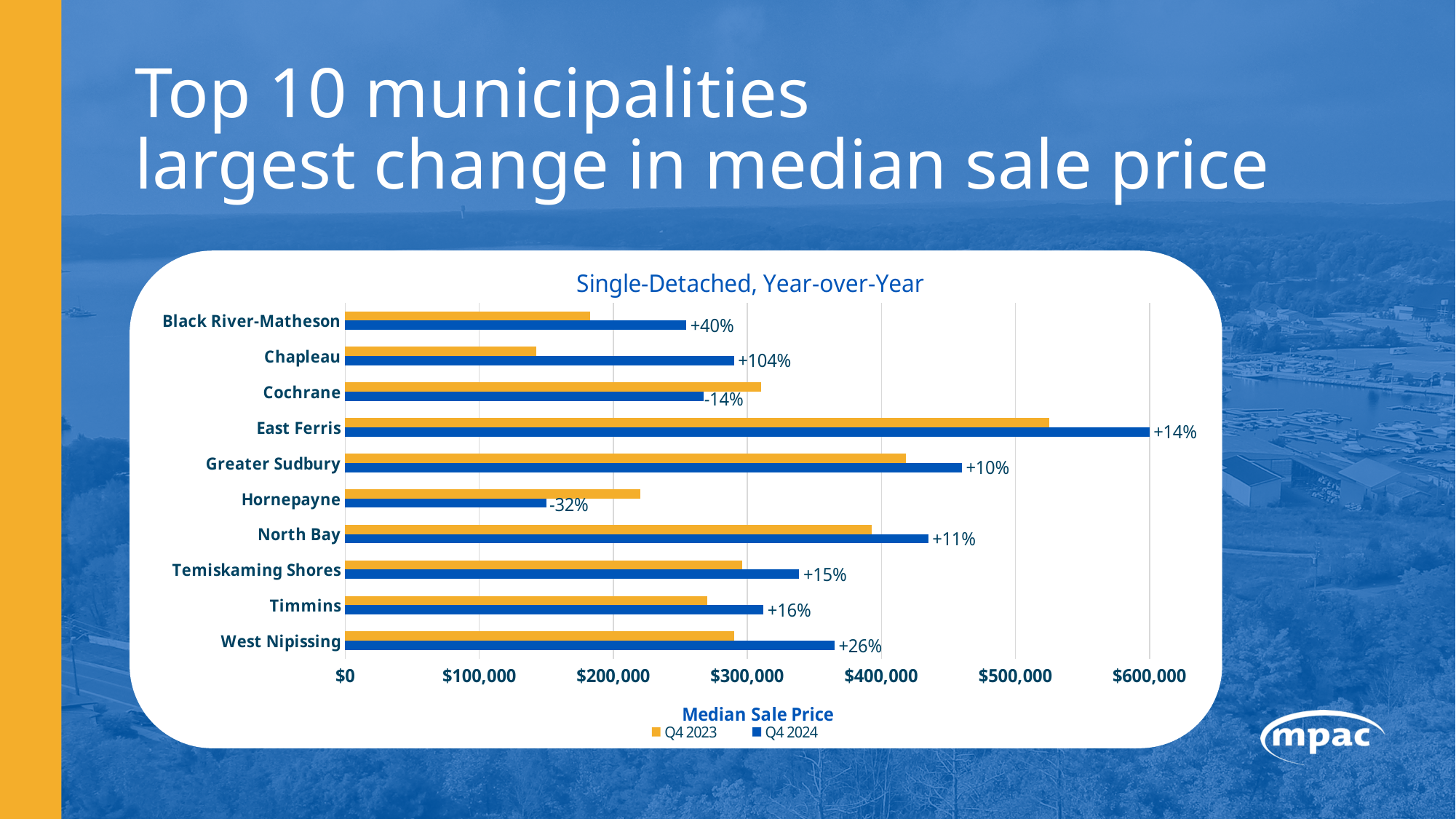
Which municipality has the largest percentage change label on the chart? Chapleau What is the subtitle shown above the chart? Single-Detached, Year-over-Year Is the Q4 2024 median sale price for Hornepayne greater or less than $200,000? less What kind of chart is shown on the slide? Bar chart What is the year-over-year percentage change shown for Hornepayne? -32% What is the year-over-year percentage change shown for West Nipissing? +26% For Cochrane, which is larger: the Q4 2023 or the Q4 2024 median sale price? Q4 2023 How many municipalities are listed on the chart? 10 What is the year-over-year percentage change shown for Chapleau? +104% Is the Q4 2024 median sale price for East Ferris greater or less than $500,000? greater Which municipality has the lowest percentage change label on the chart? Hornepayne How many series does the chart's legend list? 2